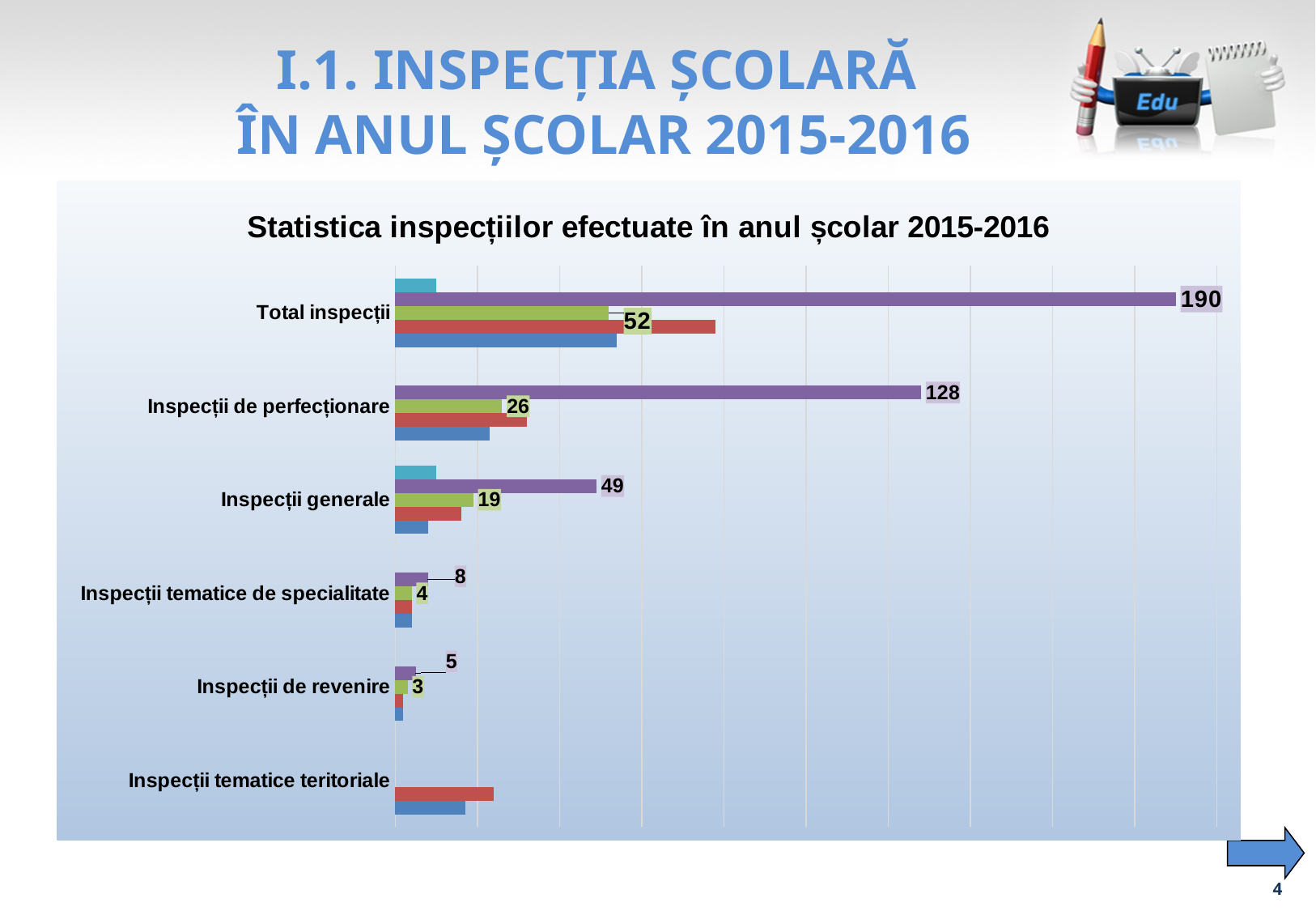
For Inspecții generale, which is larger: the purple bar value or the green bar value? the purple bar (49) What is the value of the purple bar for Total inspecții? 190 What is the value of the green bar for Inspecții de revenire? 3 How many categories are shown on the chart's vertical axis? 6 What is the value of the purple bar for Inspecții de perfecționare? 128 What is the difference between the purple bar values for Total inspecții and Inspecții de perfecționare? 62 What is the value of the purple bar for Inspecții tematice de specialitate? 8 What kind of chart is shown on the slide? bar chart Which category has the highest labelled purple bar value? Total inspecții What is the title of the chart? Statistica inspecțiilor efectuate în anul școlar 2015-2016 Which category has the lowest labelled green bar value? Inspecții de revenire What is the value of the green bar for Inspecții generale? 19